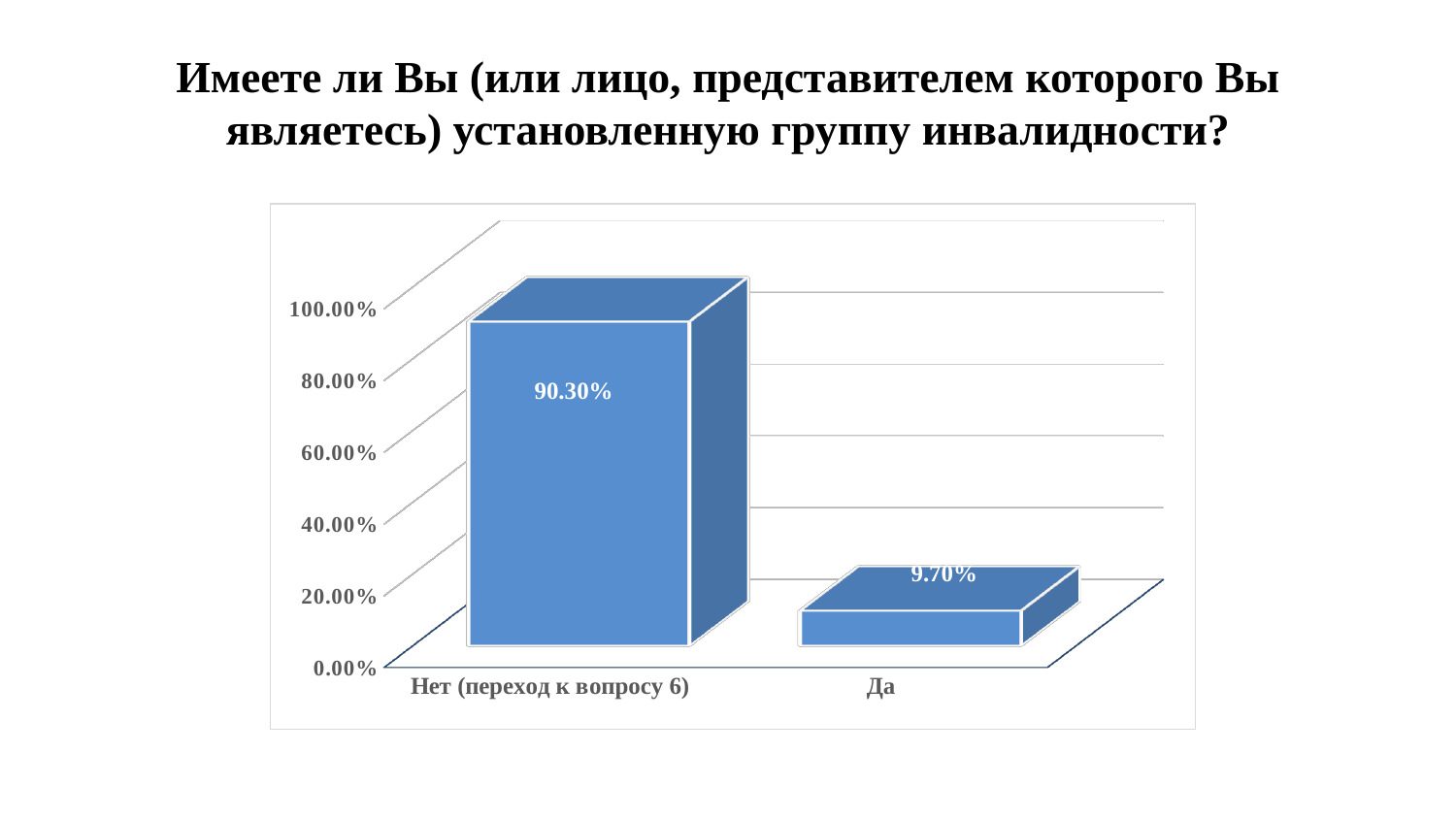
What is the value for "Нет (переход к вопросу 6)"? 90.30% What kind of chart is shown on the slide? bar chart What is the difference between the values for "Нет (переход к вопросу 6)" and "Да"? 80.60% What is the value for "Да"? 9.70% What is the total of the two values shown on the chart? 100.00% How many categories are shown on the chart? 2 Is the value for "Нет (переход к вопросу 6)" greater or less than 80.00%? greater What is the highest value shown on the vertical axis? 100.00% Which category has the lowest value? Да Is the value for "Да" greater or less than 20.00%? less Which is larger, the value for "Да" or the value for "Нет (переход к вопросу 6)"? Нет (переход к вопросу 6) Which category has the highest value? Нет (переход к вопросу 6)